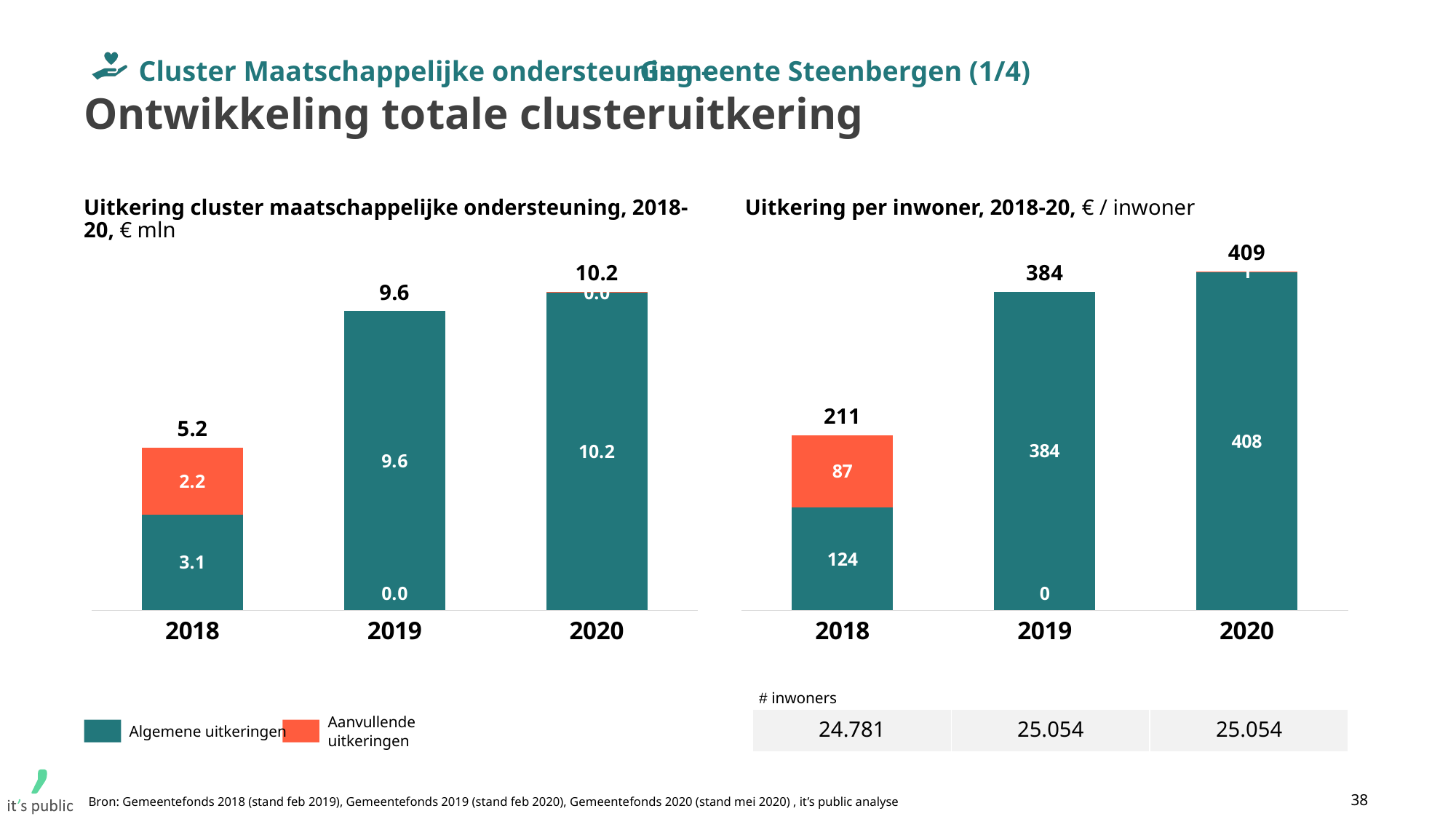
In the chart 'Uitkering cluster maatschappelijke ondersteuning, 2018-20', what is the difference between the 2020 total and the 2019 total? 0.6 In the chart 'Uitkering per inwoner, 2018-20', which year has the highest total? 2020 How many series does the legend on the slide list? 2 In the chart 'Uitkering per inwoner, 2018-20', is the total for 2019 larger or smaller than the total for 2018? larger In the chart 'Uitkering cluster maatschappelijke ondersteuning, 2018-20', what is the value of Algemene uitkeringen for 2018? 3.1 In the chart 'Uitkering cluster maatschappelijke ondersteuning, 2018-20', what is the value of Aanvullende uitkeringen for 2018? 2.2 In the chart 'Uitkering per inwoner, 2018-20', what is the value of Algemene uitkeringen for 2020? 408 In the chart 'Uitkering per inwoner, 2018-20', what is the difference between the 2019 total and the 2018 total? 173 In the chart 'Uitkering cluster maatschappelijke ondersteuning, 2018-20', which year has the lowest total? 2018 What kind of chart is 'Uitkering cluster maatschappelijke ondersteuning, 2018-20'? stacked bar chart In the chart 'Uitkering cluster maatschappelijke ondersteuning, 2018-20', what total is printed above the 2020 bar? 10.2 In the chart 'Uitkering per inwoner, 2018-20', what is the value of Aanvullende uitkeringen for 2018? 87